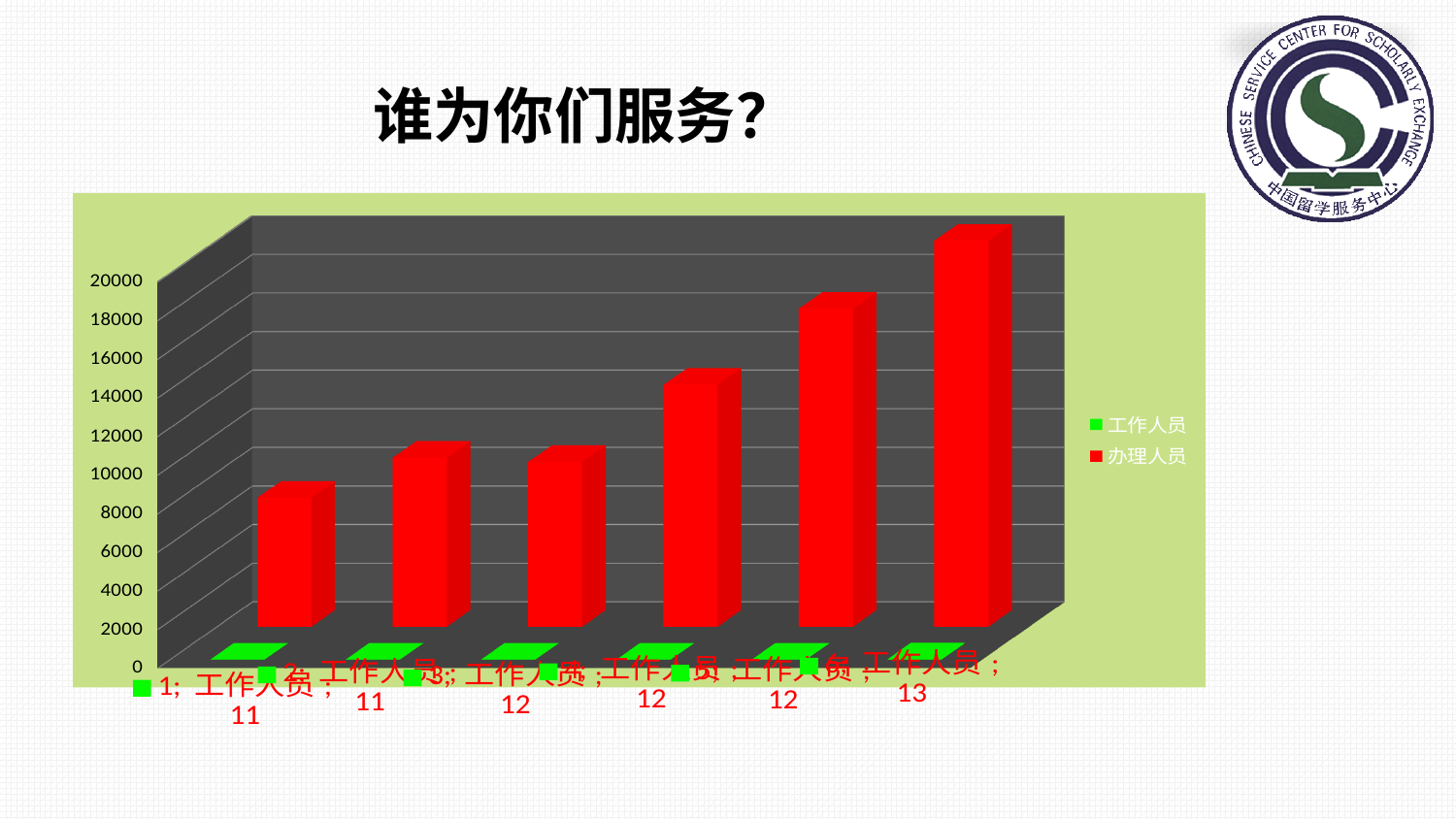
How many series does the legend list? 2 Is the 办理人员 value for the fifth category greater or less than 16000? greater Which category has the lowest 办理人员 value? category 1 What kind of chart is shown on the slide? bar chart What colour represents 办理人员 in the legend? red What is the 工作人员 value for the rightmost category? 13 What is the 工作人员 value for category 3? 12 Is the 办理人员 value for category 1 greater or less than 10000? less What is the 工作人员 value for category 1? 11 Which category has the highest 办理人员 value? the rightmost category How many categories are plotted along the x axis? 6 Do the 办理人员 values generally rise or fall from left to right along the x axis? rise